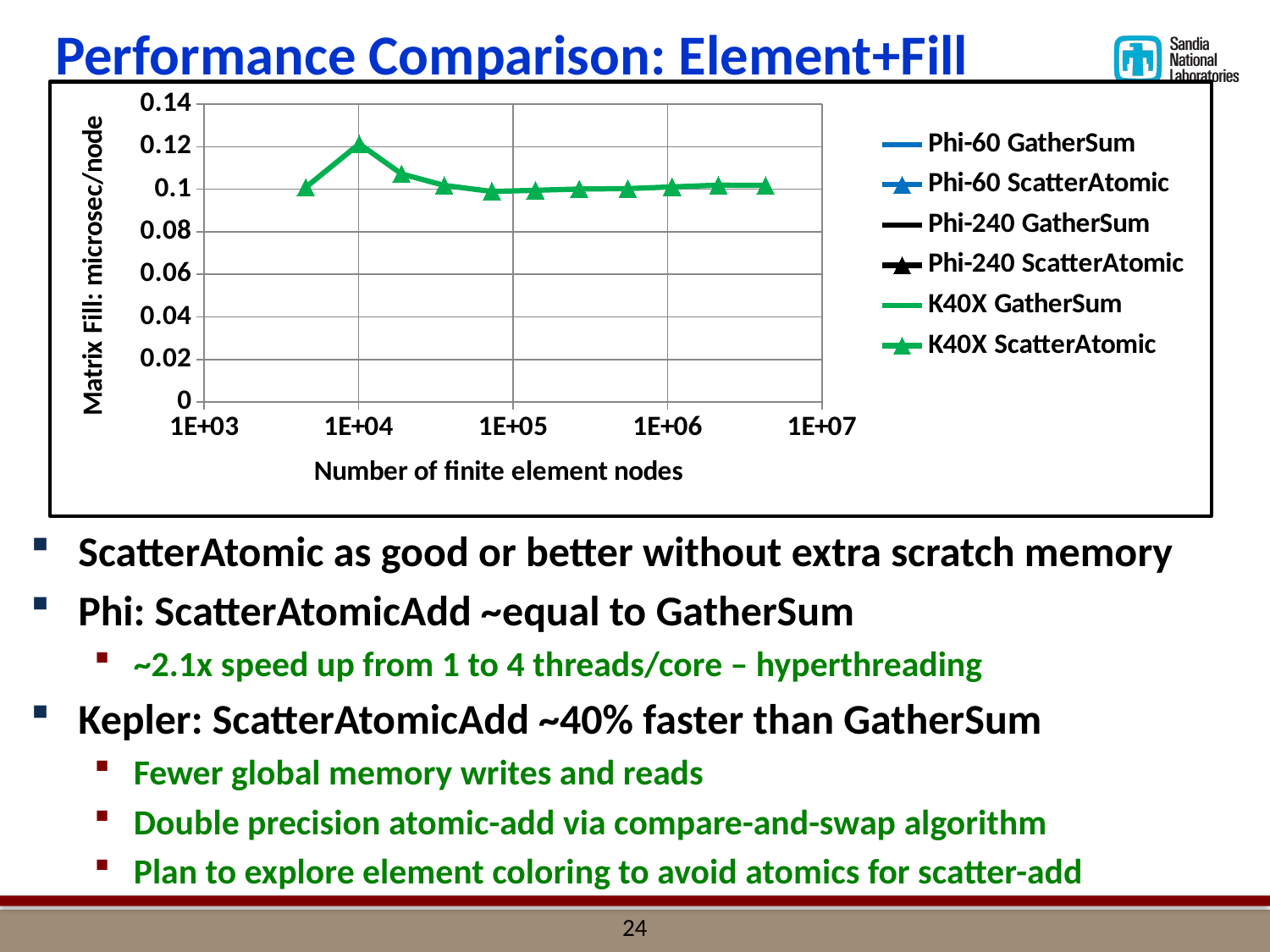
At which x-axis tick does the plotted line reach its highest value? 1E+04 Is the plotted value at 1E+04 larger or smaller than the value at 1E+06? larger What is the title of the chart's y axis? Matrix Fill: microsec/node What is the maximum value shown on the chart's y axis? 0.14 Is the highest plotted value greater or less than 0.14? less Is the plotted value at 1E+04 finite element nodes greater or less than 0.1? greater What kind of chart is shown on the slide? line chart Is the plotted value at 1E+06 finite element nodes greater or less than 0.08? greater Do the plotted values rise or fall between 1E+04 and 1E+05 finite element nodes? fall What is the title of the chart's x axis? Number of finite element nodes How many series does the chart's legend list? 6